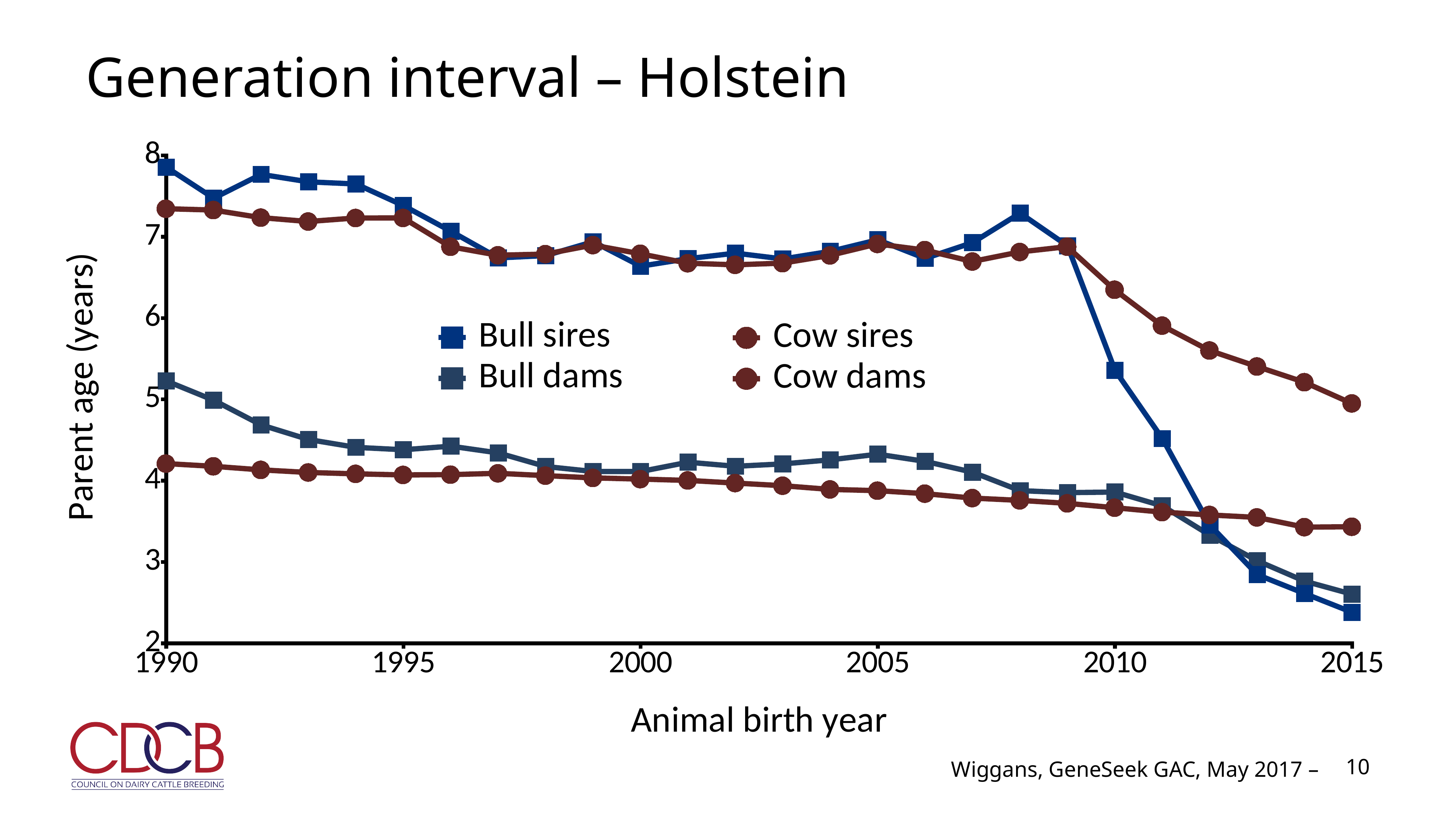
Is the value for Cow sires in 2015 greater or less than 4? greater Is the value for Bull sires in 1990 greater or less than 7? greater What is the label of the vertical axis? Parent age (years) How many series does the legend list? 4 In 2015, which series has the larger value: Cow sires or Cow dams? Cow sires Is the value for Bull sires in 2015 greater or less than 3? less In 1990, which series has the larger value: Bull sires or Bull dams? Bull sires Do the values for Cow dams rise or fall from 1990 to 2015? fall What is the title of the chart? Generation interval – Holstein What kind of chart is shown on the slide? line chart Do the values for Bull sires rise or fall from 2009 to 2015? fall